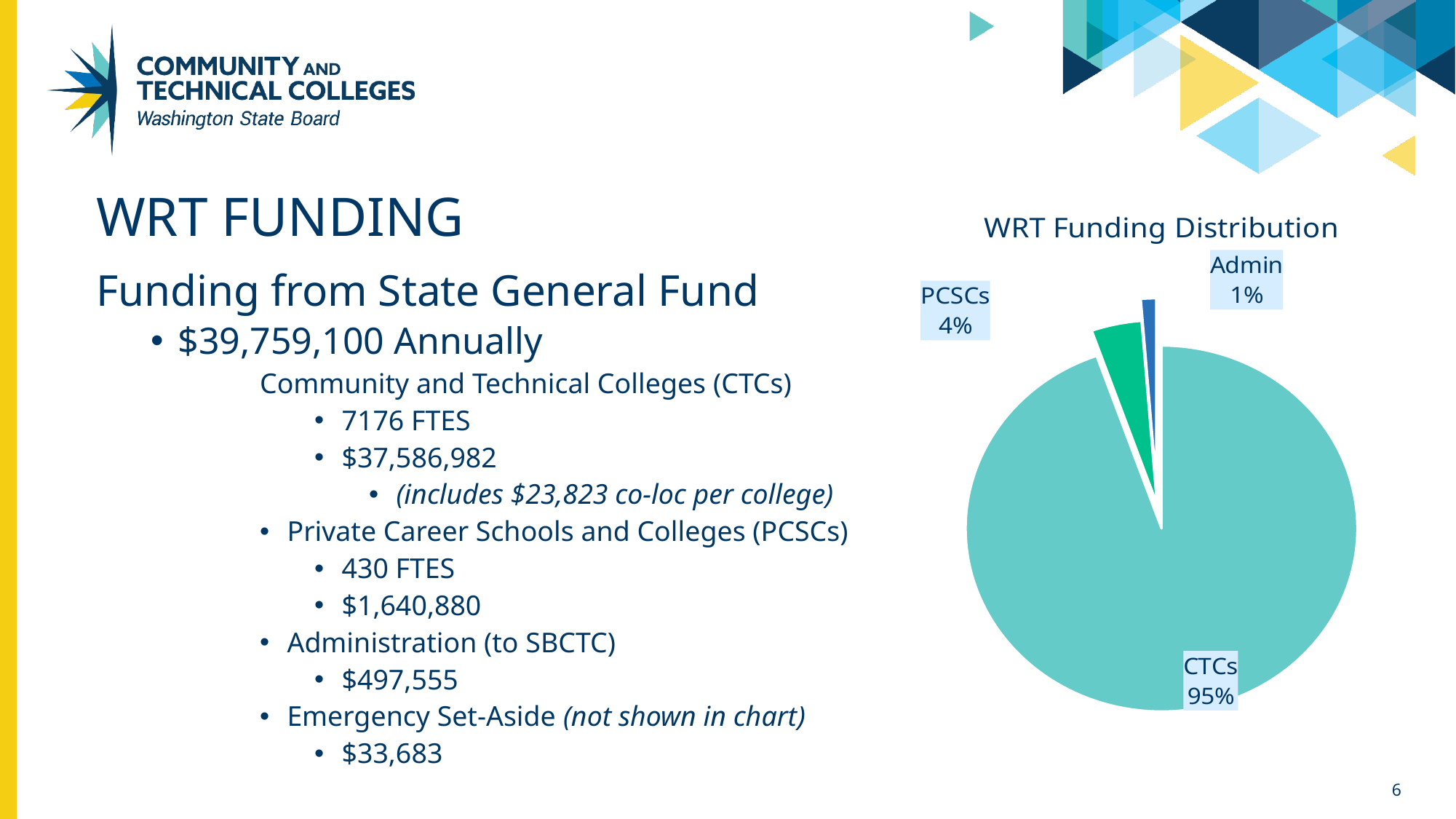
What share of WRT funding goes to CTCs according to the pie chart? 95% What is the difference in percentage points between the CTCs share and the PCSCs share? 91 percentage points Which slice of the pie chart is the smallest? Admin Which is larger in the pie chart, the PCSCs share or the Admin share? PCSCs Which category is noted on the slide as not shown in the chart? Emergency Set-Aside What share of WRT funding goes to PCSCs according to the pie chart? 4% What share of WRT funding goes to Admin according to the pie chart? 1% How many slices does the pie chart have? 3 What is the title of the chart? WRT Funding Distribution Which slice of the pie chart is the largest? CTCs What is the difference in percentage points between the PCSCs share and the Admin share? 3 percentage points What kind of chart is shown on the slide? pie chart